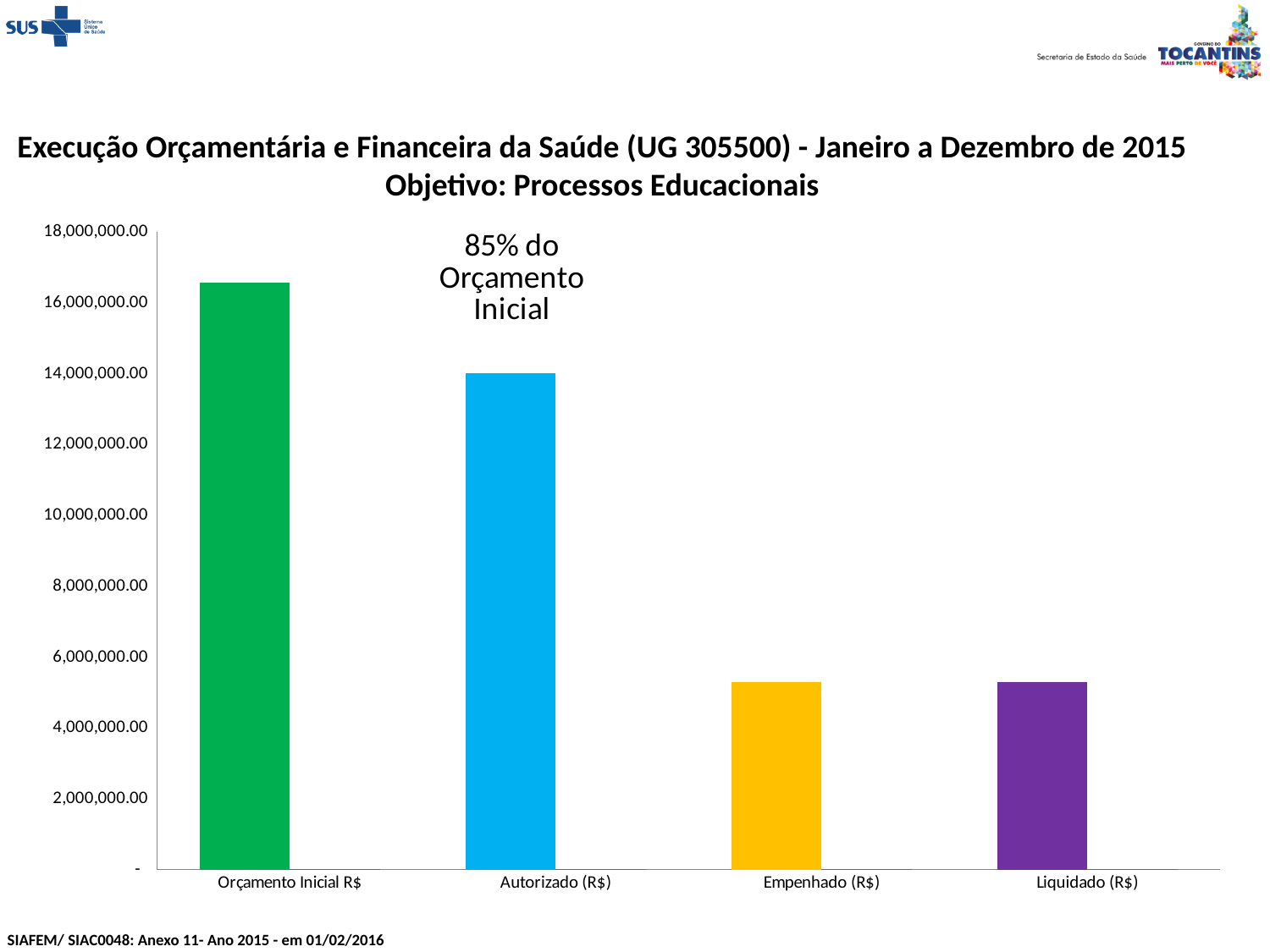
Is the value for Autorizado (R$) greater or less than 12,000,000.00? greater Which category has the highest value in the chart? Orçamento Inicial R$ What colour is the bar for Autorizado (R$)? Blue Is the value for Liquidado (R$) greater or less than 4,000,000.00? greater Which is larger, the value for Autorizado (R$) or the value for Empenhado (R$)? Autorizado (R$) What does the text annotation above the Autorizado (R$) bar say? 85% do Orçamento Inicial How many categories are plotted on the x axis of the chart? 4 Is the value for Orçamento Inicial R$ greater or less than 16,000,000.00? greater Do the bar values generally rise or fall from left to right along the x axis? Fall What kind of chart is shown on the slide? Bar chart Which is larger, the value for Orçamento Inicial R$ or the value for Autorizado (R$)? Orçamento Inicial R$